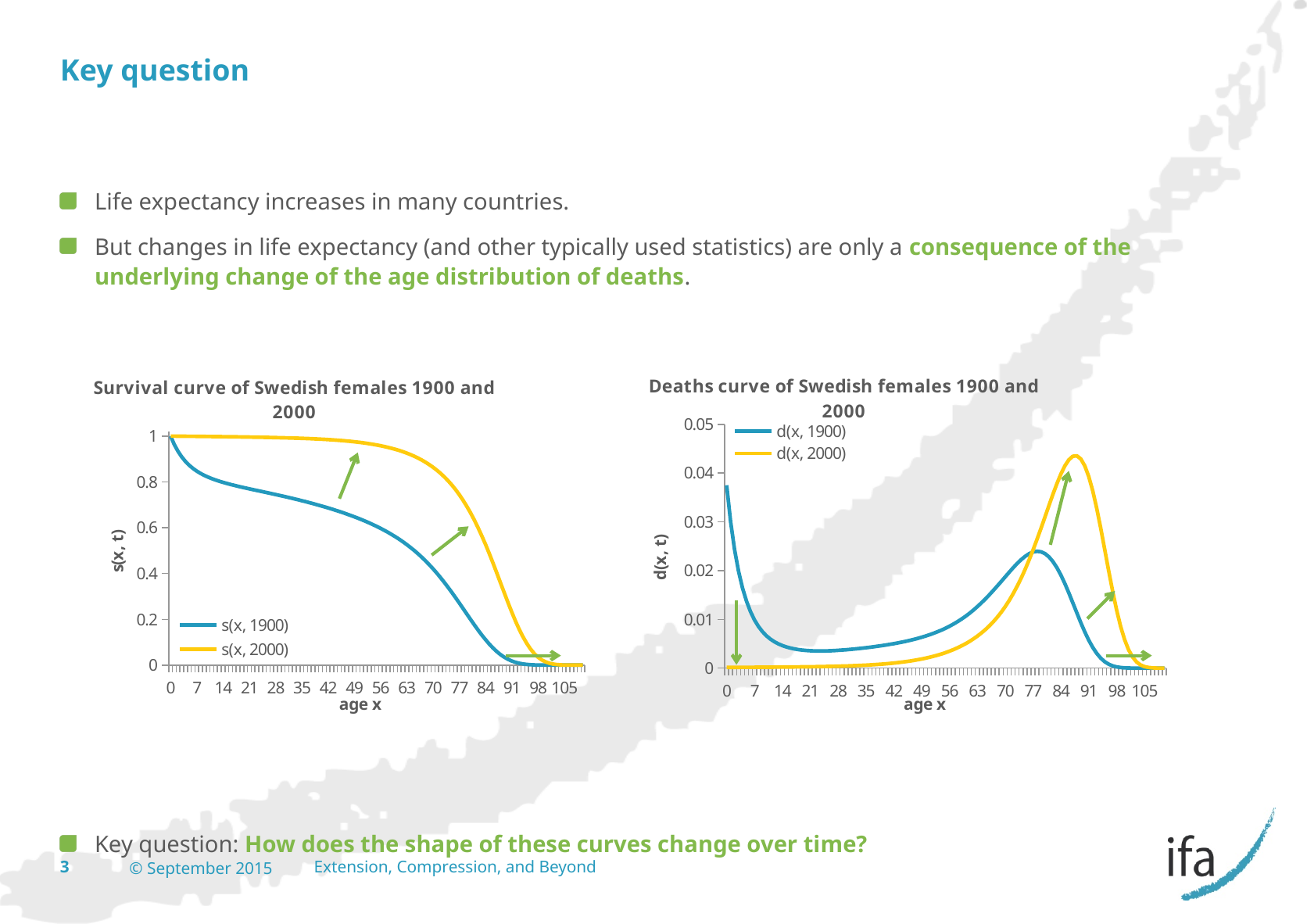
In the 'Survival curve of Swedish females 1900 and 2000' chart, is the value of s(x, 1900) at age 49 greater or less than 0.8? less What is the label of the x axis on the 'Deaths curve of Swedish females 1900 and 2000' chart? age x What type of chart is the 'Survival curve of Swedish females 1900 and 2000'? line chart In the 'Survival curve of Swedish females 1900 and 2000' chart, do the survival curves rise or fall as age increases? fall In the 'Survival curve of Swedish females 1900 and 2000' chart, which series has the higher value at age 70, s(x, 1900) or s(x, 2000)? s(x, 2000) In the 'Survival curve of Swedish females 1900 and 2000' chart, what is the value of s(x, 1900) at age 0? 1 In the 'Survival curve of Swedish females 1900 and 2000' chart, is the value of s(x, 2000) at age 49 greater or less than 0.8? greater In the 'Deaths curve of Swedish females 1900 and 2000' chart, is the value of d(x, 1900) at age 0 greater or less than 0.03? greater In the 'Deaths curve of Swedish females 1900 and 2000' chart, which series reaches the higher peak, d(x, 1900) or d(x, 2000)? d(x, 2000) How many series does the legend of the 'Deaths curve of Swedish females 1900 and 2000' chart list? 2